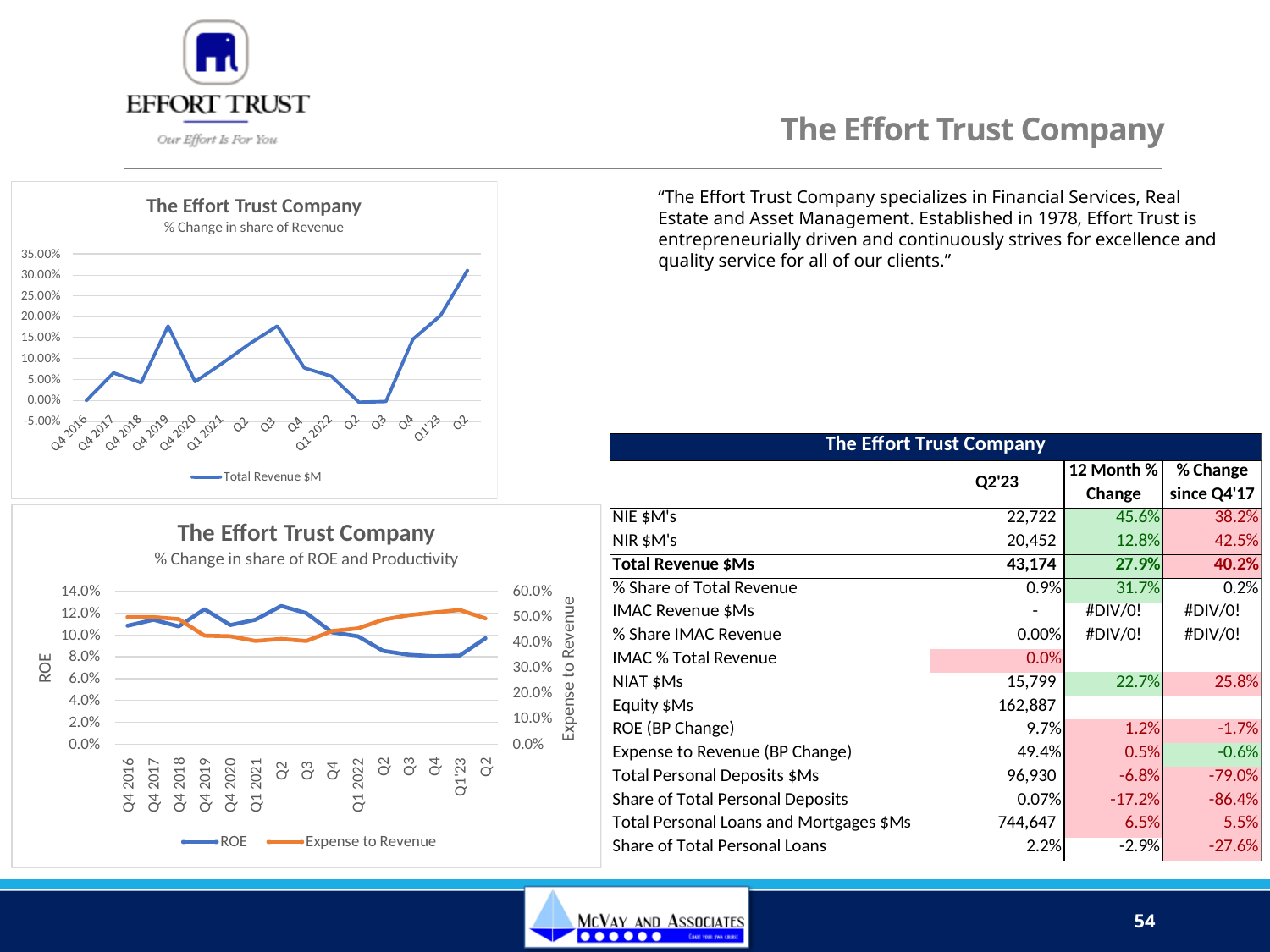
In the bottom chart (% Change in share of ROE and Productivity), is the ROE value for Q4 2022 greater or less than 10.0%? less In the top chart (% Change in share of Revenue), is the value for Q4 2018 greater or less than 10.00%? less In the bottom chart (% Change in share of ROE and Productivity), what is the title of the right-hand vertical axis? Expense to Revenue In the top chart (% Change in share of Revenue), is the value for Q4 2019 greater or less than 15.00%? greater In the bottom chart (% Change in share of ROE and Productivity), does the ROE line overall rise or fall from Q4 2016 to Q2 2023? fall In the top chart (% Change in share of Revenue), which period has the highest value? Q2 (the last point) In the top chart (% Change in share of Revenue), what is the name of the series shown in the legend? Total Revenue $M How many series does the legend of the top chart (% Change in share of Revenue) list? 1 In the top chart (% Change in share of Revenue), how many points are plotted along the x axis? 15 What kind of chart is the top chart titled "% Change in share of Revenue"? line chart How many series does the legend of the bottom chart (% Change in share of ROE and Productivity) list? 2